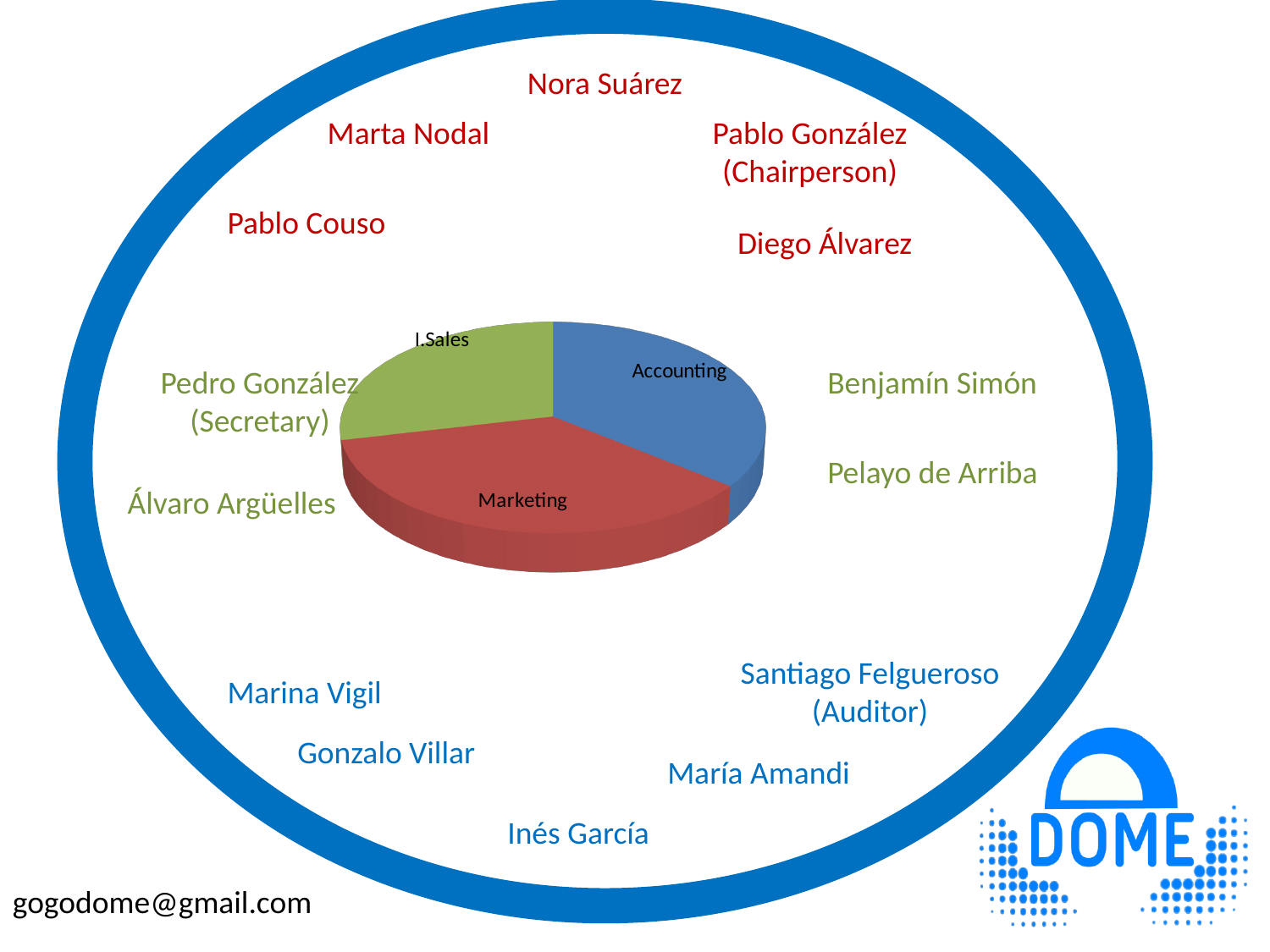
Which is larger in the pie chart, Marketing or I.Sales? Marketing How many slices does the pie chart have? 3 What are the labels of the three slices in the pie chart? I.Sales, Accounting, Marketing What colour is the Accounting slice of the pie chart? blue What kind of chart is shown on the slide? pie chart What colour is the Marketing slice of the pie chart? red